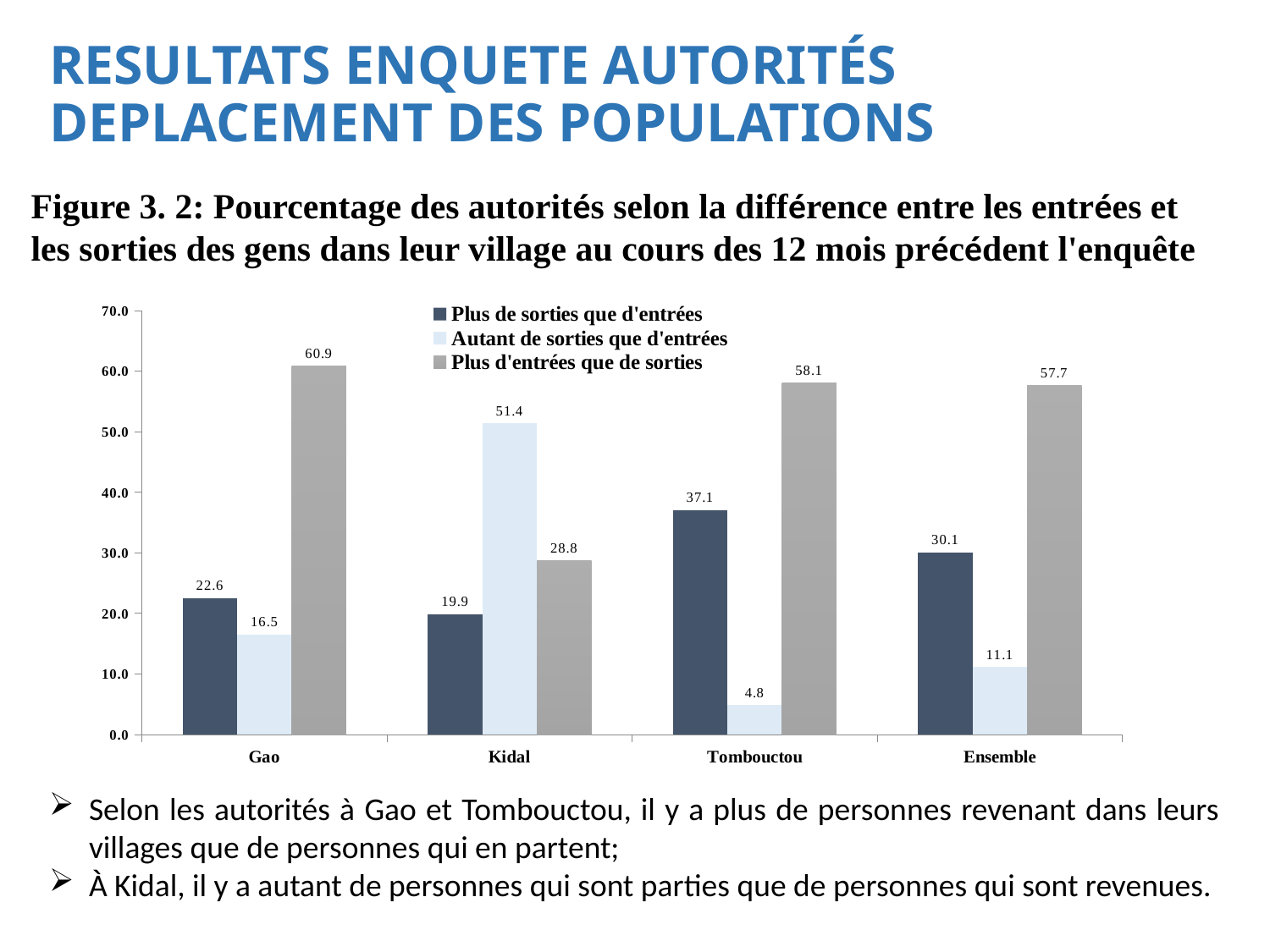
How many series does the legend list? 3 What kind of chart is shown on the slide? Bar chart What is the value for "Autant de sorties que d'entrées" for Ensemble? 11.1 Which category has the lowest value for "Autant de sorties que d'entrées"? Tombouctou Which series is shown in the darkest colour in the legend? Plus de sorties que d'entrées What is the value for "Plus d'entrées que de sorties" in Gao? 60.9 How many categories are shown on the x axis? 4 What is the value for "Autant de sorties que d'entrées" in Kidal? 51.4 Which category has the highest value for "Plus d'entrées que de sorties"? Gao What is the difference between "Plus d'entrées que de sorties" and "Plus de sorties que d'entrées" in Tombouctou? 21.0 What is the value for "Plus de sorties que d'entrées" in Tombouctou? 37.1 Which is larger in Kidal: "Autant de sorties que d'entrées" or "Plus d'entrées que de sorties"? Autant de sorties que d'entrées